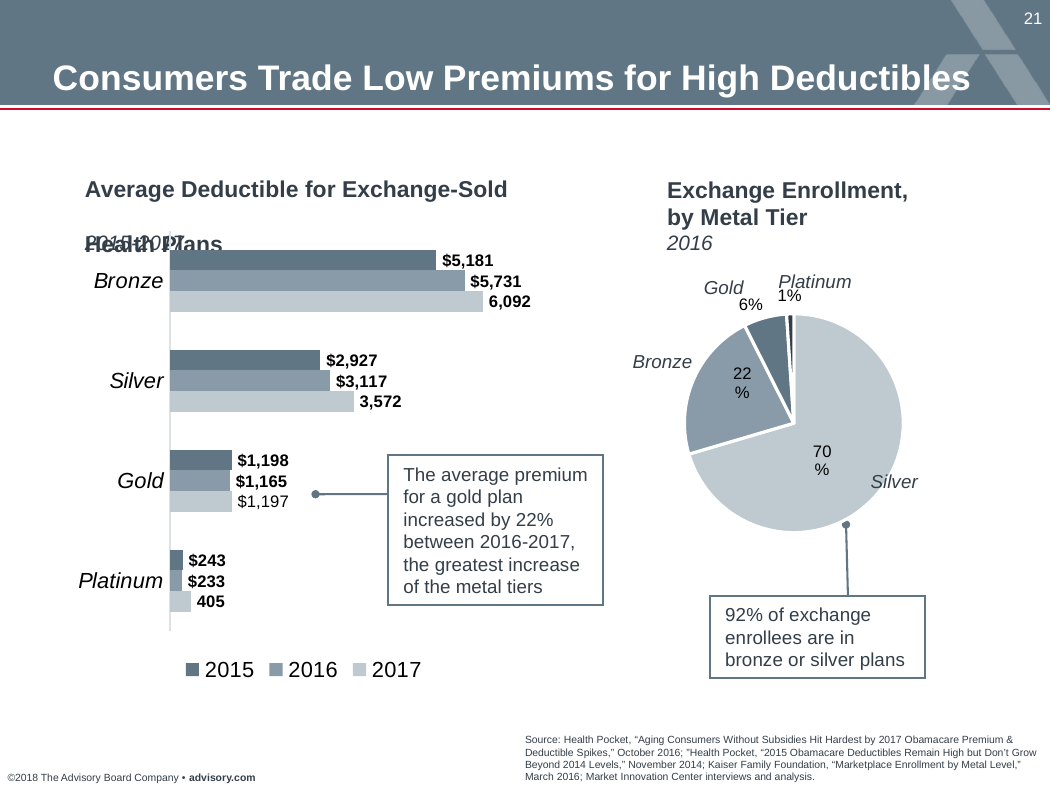
How many slices does the Exchange Enrollment, by Metal Tier pie chart have? 4 In the Average Deductible for Exchange-Sold Health Plans chart, which is larger for Gold: the 2015 value or the 2016 value? 2015 In the Exchange Enrollment, by Metal Tier pie chart, what share of enrollment is Silver? 70% In the Average Deductible for Exchange-Sold Health Plans chart, which metal tier has the lowest 2015 deductible? Platinum How many series does the legend of the Average Deductible for Exchange-Sold Health Plans chart list? 3 What kind of chart is the Average Deductible for Exchange-Sold Health Plans chart? Bar chart In the Average Deductible for Exchange-Sold Health Plans chart, what is the 2016 value for Bronze? $5,731 In the Exchange Enrollment, by Metal Tier pie chart, which metal tier has the smallest share? Platinum In the Average Deductible for Exchange-Sold Health Plans chart, what is the difference between the 2017 and 2015 values for Bronze? 911 In the Average Deductible for Exchange-Sold Health Plans chart, which metal tier has the highest 2017 deductible? Bronze In the Average Deductible for Exchange-Sold Health Plans chart, what is the 2017 value for Silver? 3,572 In the Average Deductible for Exchange-Sold Health Plans chart, what is the 2015 value for Platinum? $243